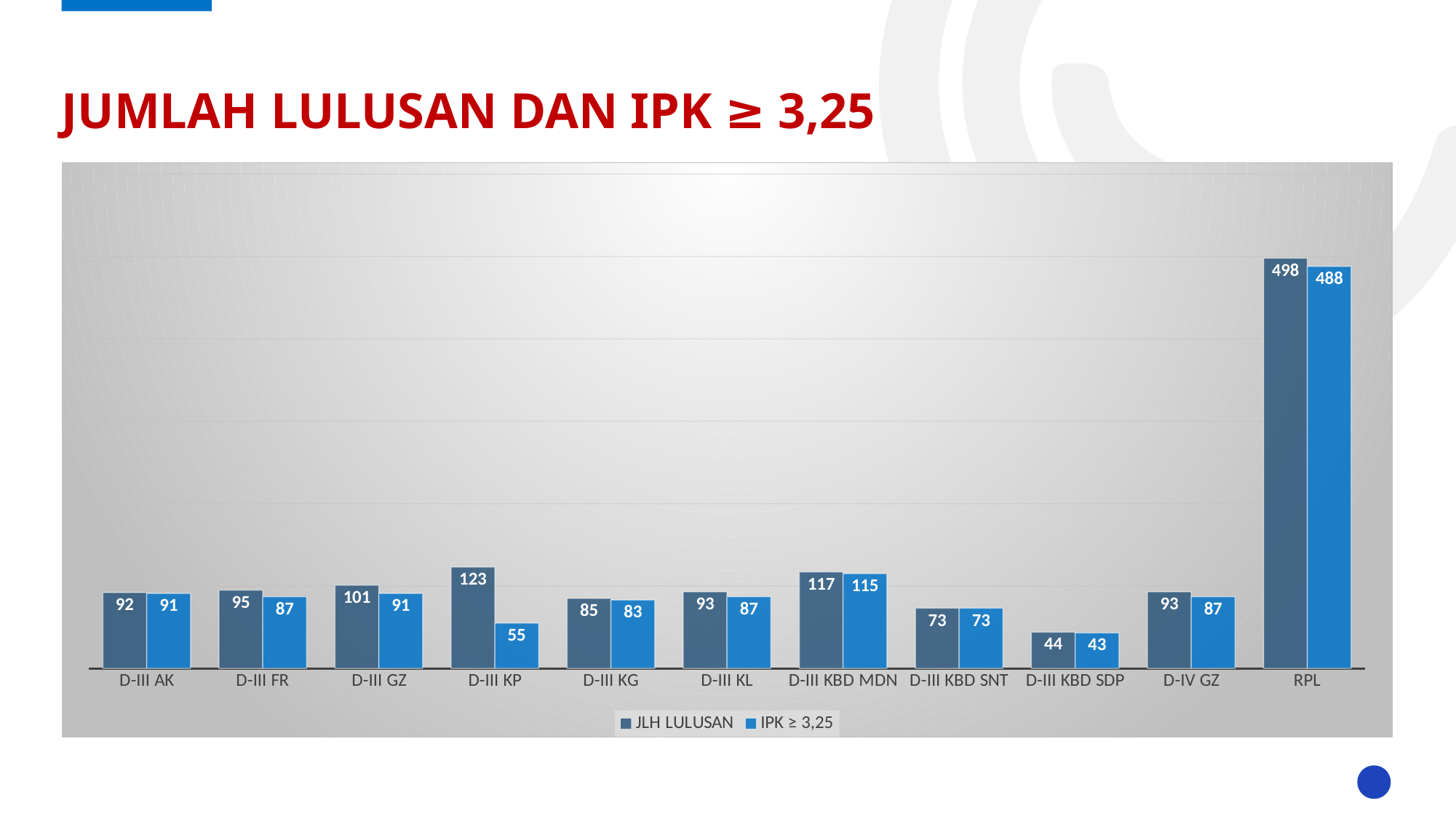
What is the title of the slide? JUMLAH LULUSAN DAN IPK ≥ 3,25 What is the IPK ≥ 3,25 value for D-III KBD MDN? 115 Which category has the lowest IPK ≥ 3,25 value? D-III KBD SDP What kind of chart is shown on the slide? Bar chart What is the difference between the JLH LULUSAN and IPK ≥ 3,25 values for D-III KP? 68 How many categories are shown on the x axis? 11 What is the difference between the JLH LULUSAN values for RPL and D-III KP? 375 Which is larger, the IPK ≥ 3,25 value for D-III FR or for D-III GZ? D-III GZ What is the IPK ≥ 3,25 value for RPL? 488 How many series does the legend list? 2 Which category has the highest JLH LULUSAN value? RPL What is the JLH LULUSAN value for D-III KP? 123